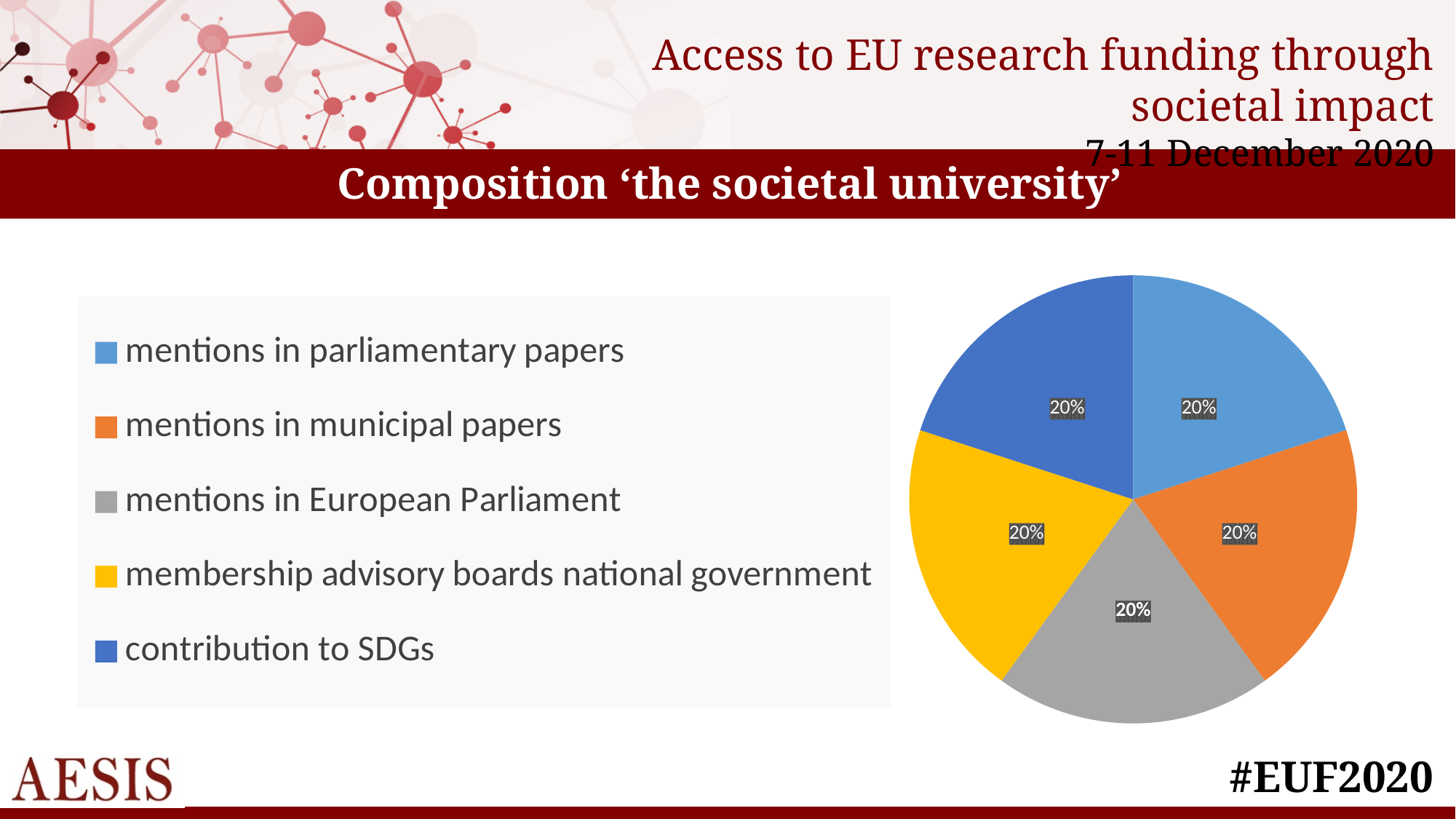
What share of the pie does 'mentions in parliamentary papers' represent? 20% What is the combined share of 'mentions in parliamentary papers' and 'mentions in municipal papers'? 40% What share of the pie does 'mentions in European Parliament' represent? 20% Which colour represents 'membership advisory boards national government' in the pie chart? yellow What kind of chart is shown on the slide? pie chart What is the difference between the share for 'contribution to SDGs' and the share for 'mentions in municipal papers'? 0% What is the title of the chart on the slide? Composition 'the societal university' Is the share for 'mentions in European Parliament' greater or less than 25%? less How many slices does the pie chart have? 5 What share of the pie does 'mentions in municipal papers' represent? 20%